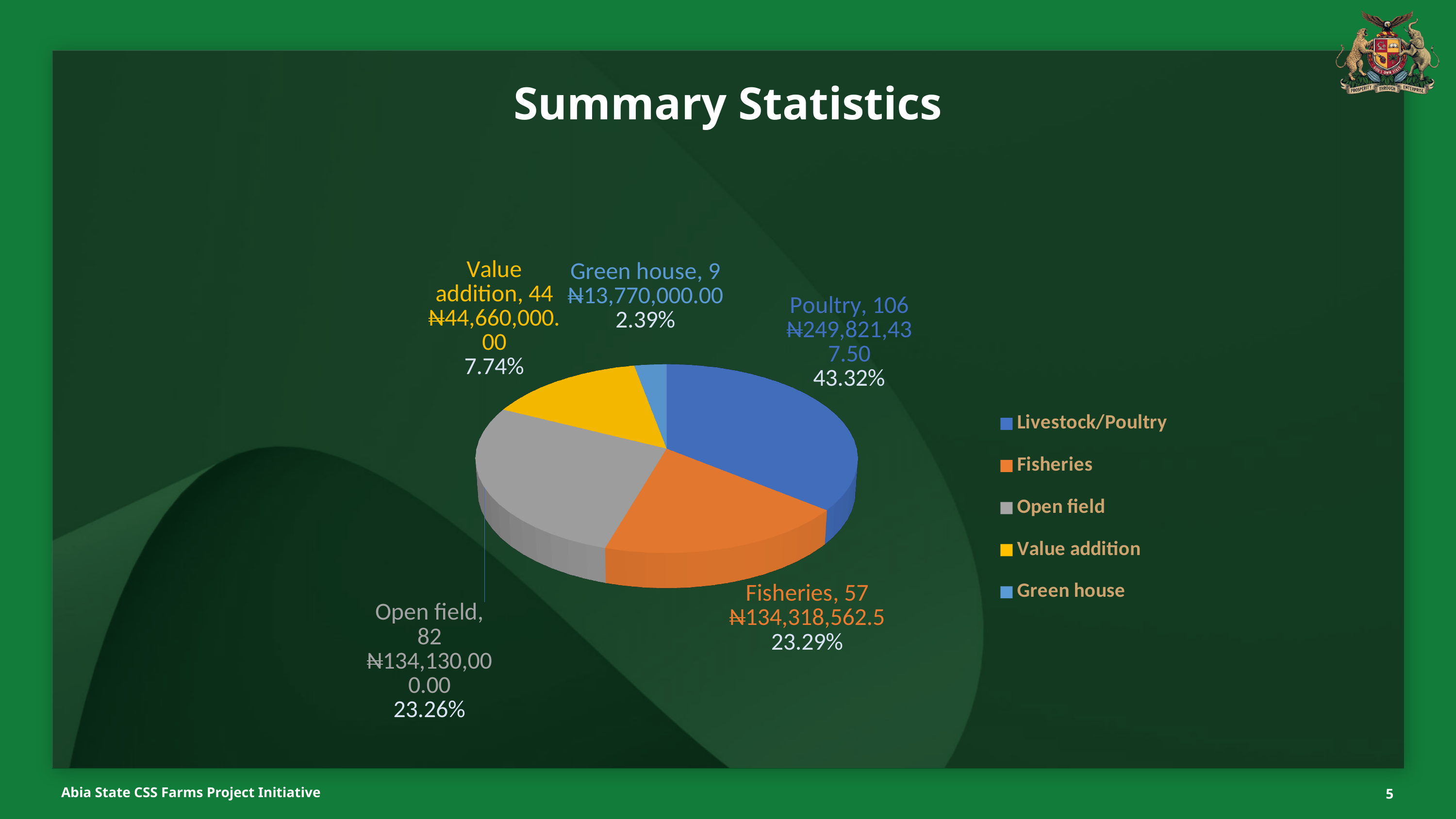
What is the count shown for Fisheries? 57 Which category has the largest slice of the pie? Poultry How many slices does the pie chart have? 5 What percentage share does the Poultry slice have? 43.32% What amount is shown for Value addition? ₦44,660,000.00 What kind of chart is shown on the slide? pie chart What is the difference between the count for Poultry and the count for Fisheries? 49 What is the count shown for Open field? 82 What amount is shown for Green house? ₦13,770,000.00 How many entries does the legend list? 5 Which category has the smallest slice of the pie? Green house What percentage share does the Green house slice have? 2.39%